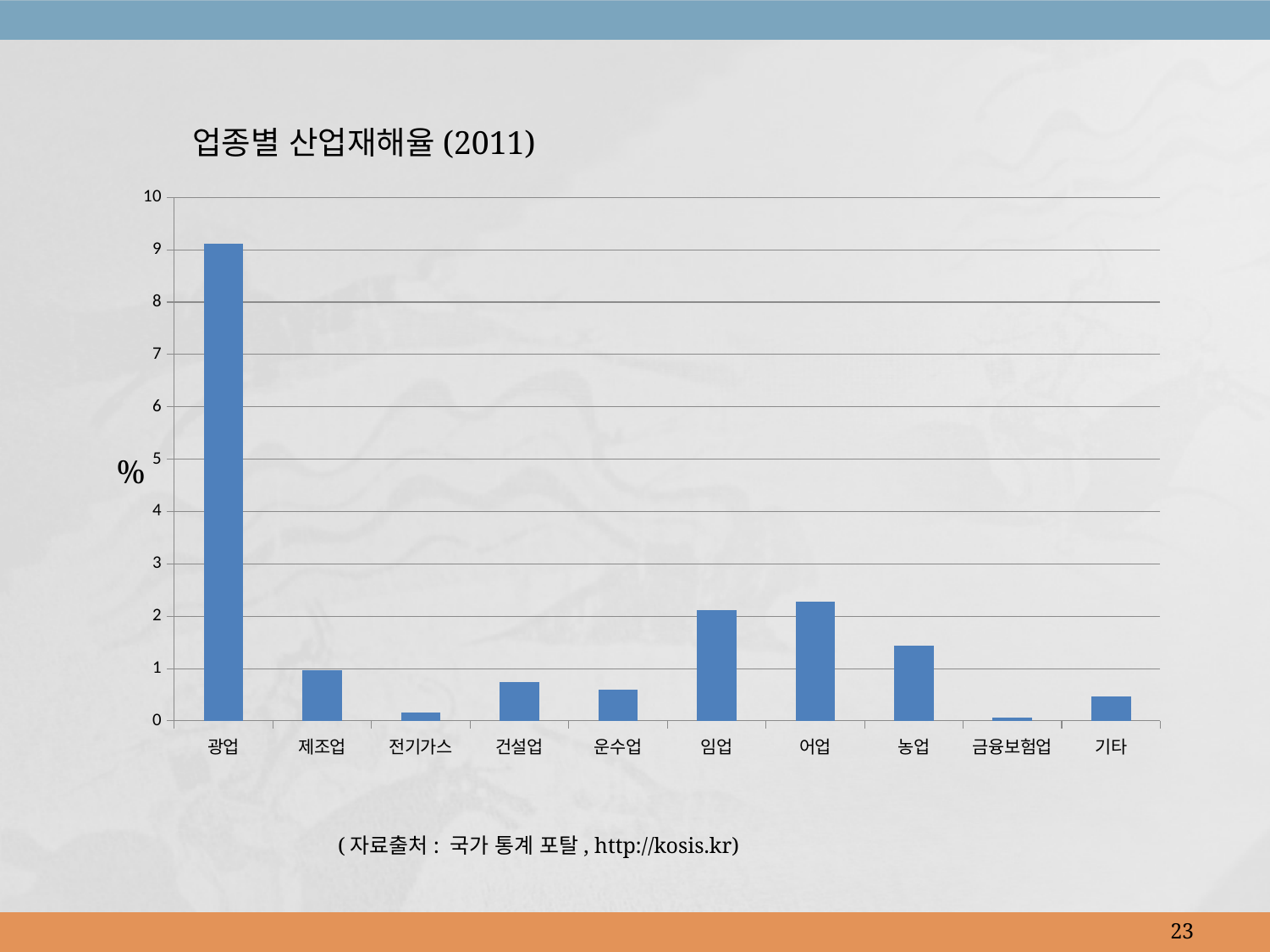
Is the value for 전기가스 greater or less than 1? less Is the value for 어업 greater or less than 2? greater Which industry has the highest industrial accident rate? 광업 Which has a higher value, 제조업 or 건설업? 제조업 Is the value for 농업 greater or less than 1? greater Which has a higher value, 농업 or 임업? 임업 Which industry has the lowest industrial accident rate? 금융보험업 How many industry categories are shown on the x axis? 10 What is the title of the chart? 업종별 산업재해율 (2011) What kind of chart is shown on the slide? bar chart